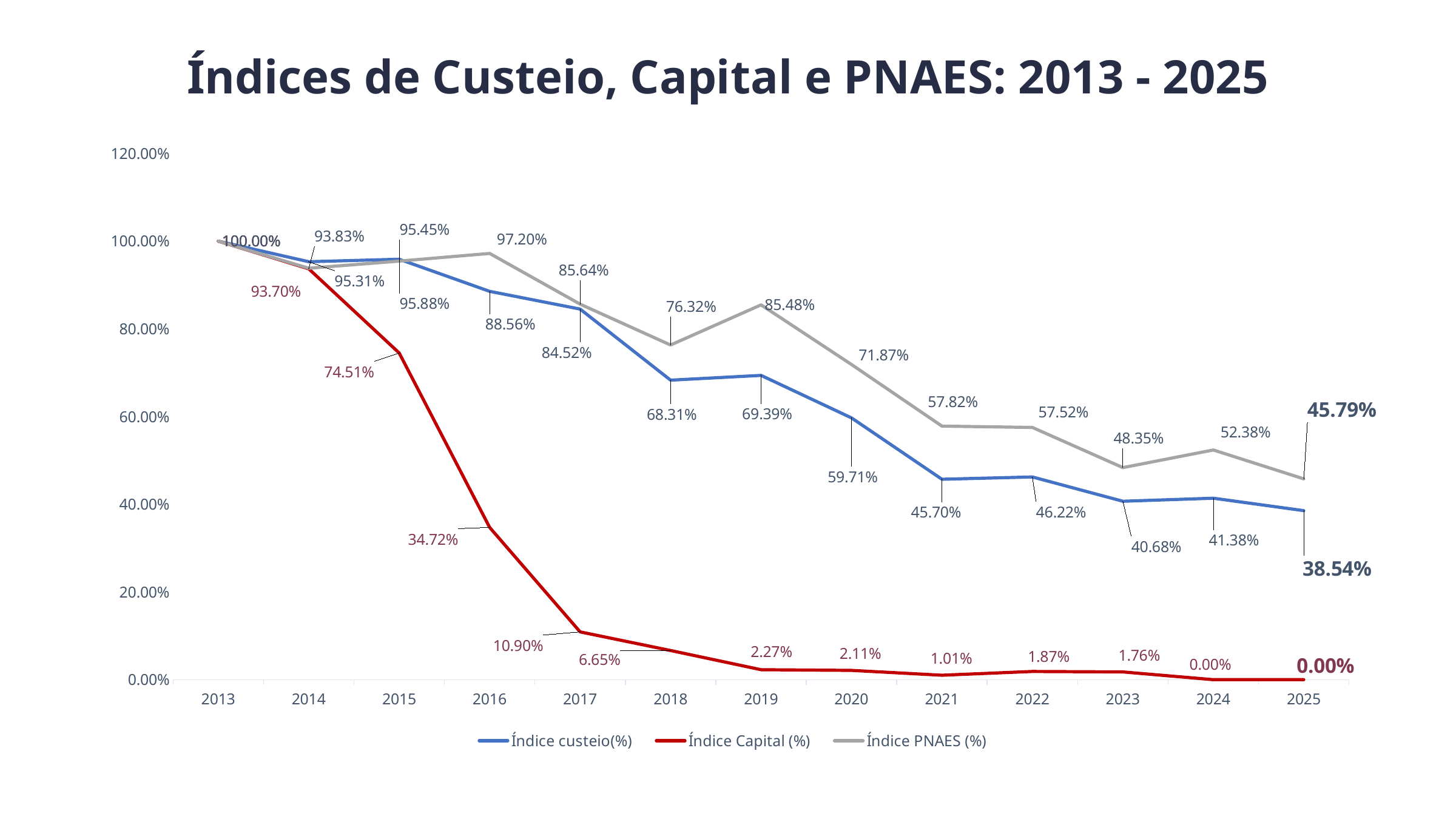
Does Índice Capital (%) rise or fall from 2013 to 2025? fall How many years are plotted along the x axis? 13 What is the difference between Índice PNAES (%) and Índice custeio(%) in 2025? 7.25% How many series does the legend list? 3 What is the value of Índice custeio(%) in 2025? 38.54% In which year is Índice custeio(%) at its lowest? 2025 What kind of chart is shown on the slide? line chart What is the value of Índice Capital (%) in 2016? 34.72% By how much did Índice Capital (%) fall from 2015 to 2016? 39.79% What is the value of Índice Capital (%) in 2017? 10.90% In 2020, which is larger: Índice custeio(%) or Índice PNAES (%)? Índice PNAES (%) What is the value of Índice PNAES (%) in 2019? 85.48%